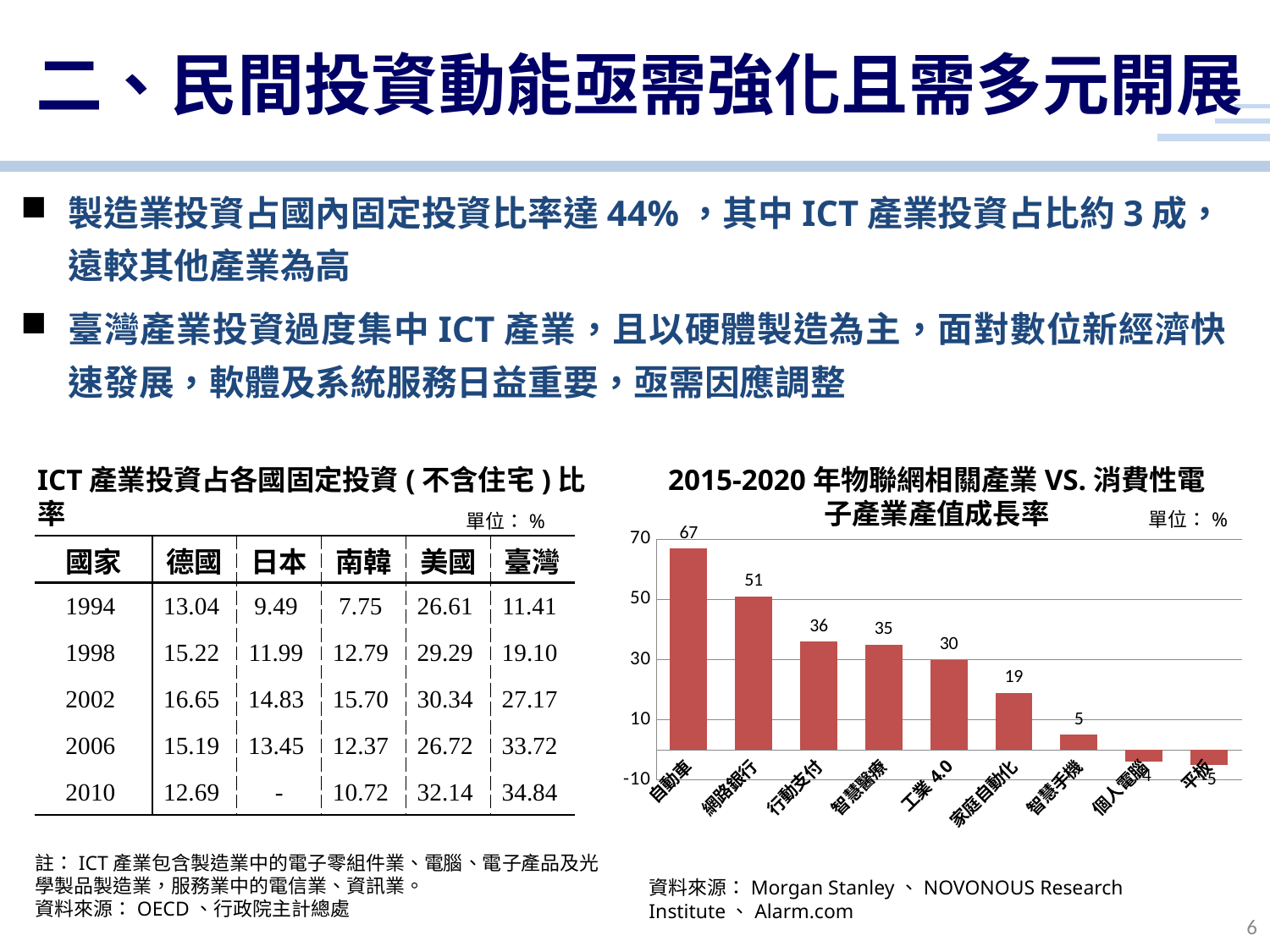
What is the difference between the values for 自動車 and 網路銀行? 16 Is the value for 個人電腦 greater or less than 10? less What is the value for 網路銀行 in the bar chart? 51 What type of chart is shown on the slide? bar chart What is the difference between the values for 行動支付 and 智慧手機? 31 What is the value for 自動車 in the bar chart? 67 How many categories are shown in the bar chart? 9 Which is larger, the value for 行動支付 or the value for 工業 4.0? 行動支付 What unit is indicated for the bar chart? % Which category has the highest value in the bar chart? 自動車 What is the value for 家庭自動化 in the bar chart? 19 What is the value for 工業 4.0 in the bar chart? 30